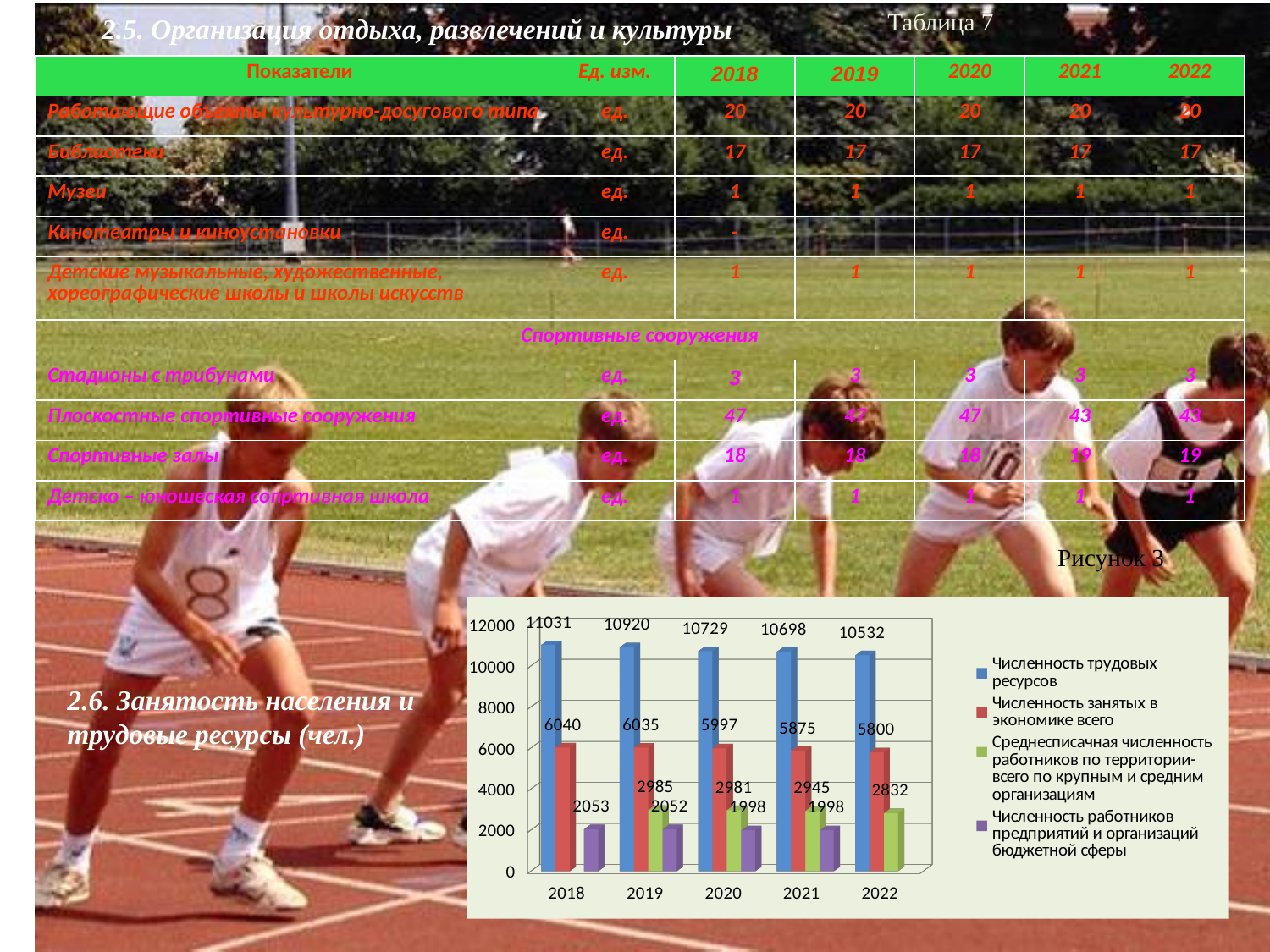
In the bar chart, what is the value of Численность работников предприятий и организаций бюджетной сферы for 2018? 2053 In the bar chart, does Численность трудовых ресурсов rise or fall from 2018 to 2022? fall In the bar chart, what is the value of Численность трудовых ресурсов for 2018? 11031 What kind of chart is shown in the lower right of the slide (Рисунок 3)? bar chart In the bar chart, what is the difference between Численность трудовых ресурсов in 2018 and in 2022? 499 In the bar chart, what is the value of Среднесписочная численность работников for 2021? 2945 In the bar chart, is Численность занятых в экономике всего larger in 2019 or in 2021? 2019 In the bar chart, how many years are shown on the x axis? 5 How many series does the legend of the bar chart list? 4 In the bar chart, what is the value of Численность занятых в экономике всего for 2022? 5800 In the bar chart, which year has the highest value of Численность трудовых ресурсов? 2018 In the bar chart, which year has the lowest value of Численность занятых в экономике всего? 2022